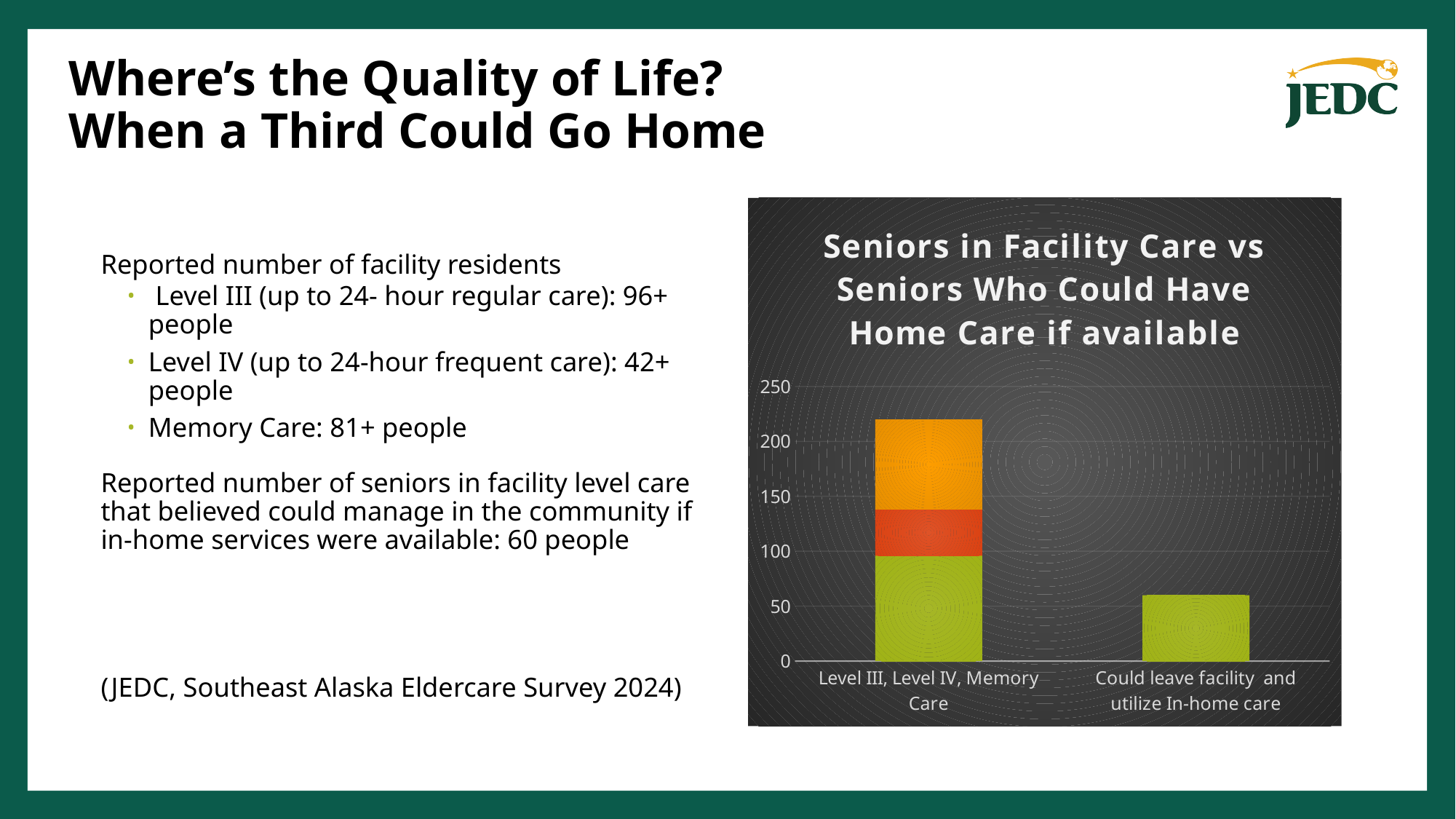
Is the value for "Could leave facility and utilize In-home care" greater or less than 100? less Is the value for "Could leave facility and utilize In-home care" greater or less than 50? greater Which category has the shortest bar in the chart? Could leave facility and utilize In-home care How many stacked segments make up the "Level III, Level IV, Memory Care" bar? 3 How many categories are shown on the x axis of the chart? 2 Which category has the tallest bar in the chart? Level III, Level IV, Memory Care Is the total value for "Level III, Level IV, Memory Care" greater or less than 200? greater Which bar is taller: "Level III, Level IV, Memory Care" or "Could leave facility and utilize In-home care"? Level III, Level IV, Memory Care What kind of chart is shown on the slide? Bar chart Do the bar heights rise or fall from left to right across the x axis? Fall What is the title of the chart? Seniors in Facility Care vs Seniors Who Could Have Home Care if available